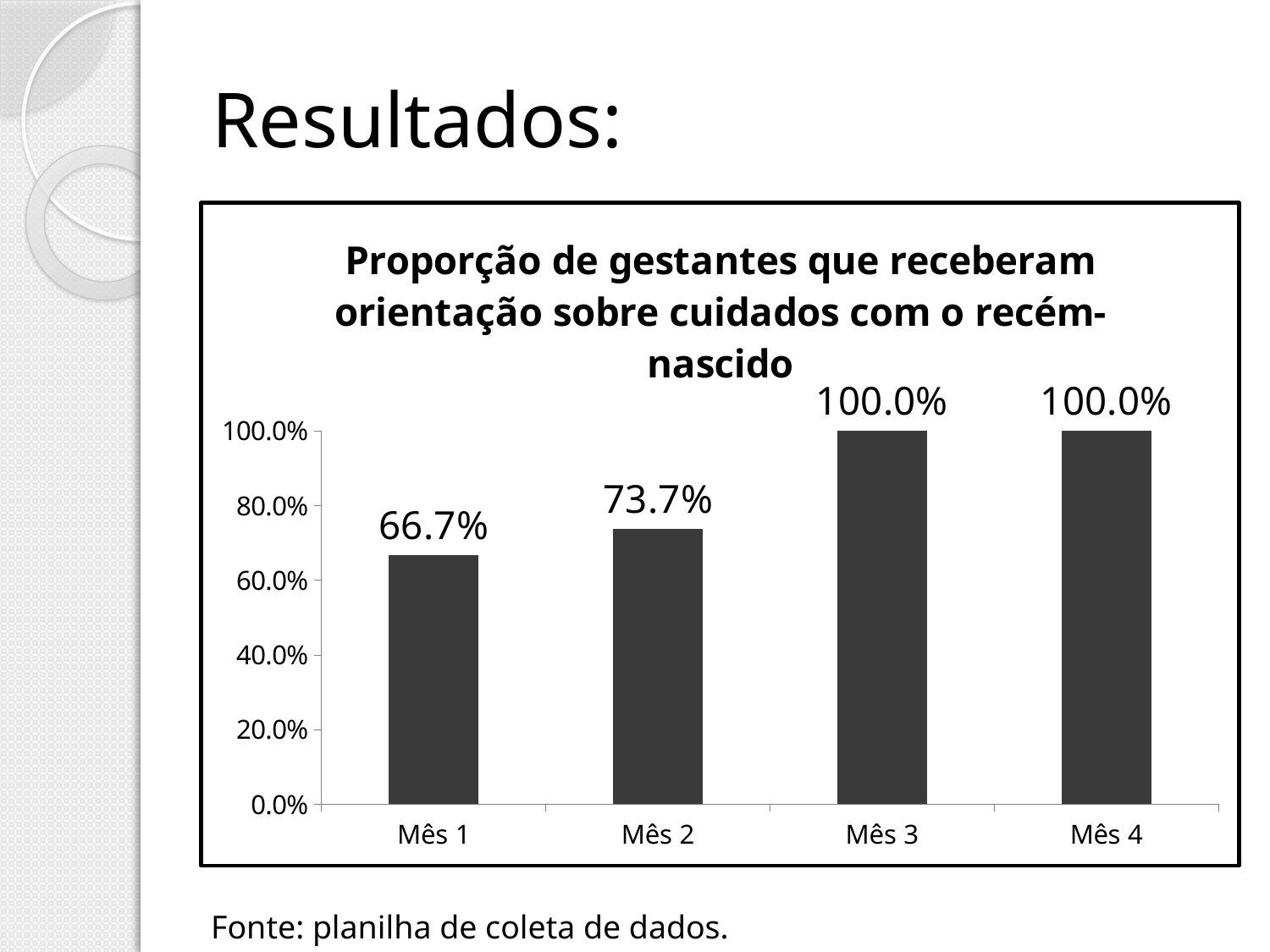
Is the value for Mês 1 greater or less than 80.0%? less What is the value for Mês 3? 100.0% Which month has the lowest value? Mês 1 What is the value for Mês 1? 66.7% What is the value for Mês 2? 73.7% What is the difference between the values for Mês 3 and Mês 2? 26.3% What is the value for Mês 4? 100.0% What is the difference between the values for Mês 2 and Mês 1? 7.0% What kind of chart is shown on the slide? bar chart Which is larger, the value for Mês 1 or the value for Mês 2? Mês 2 Do the values rise or fall from Mês 1 to Mês 4? rise How many months are shown on the x axis? 4